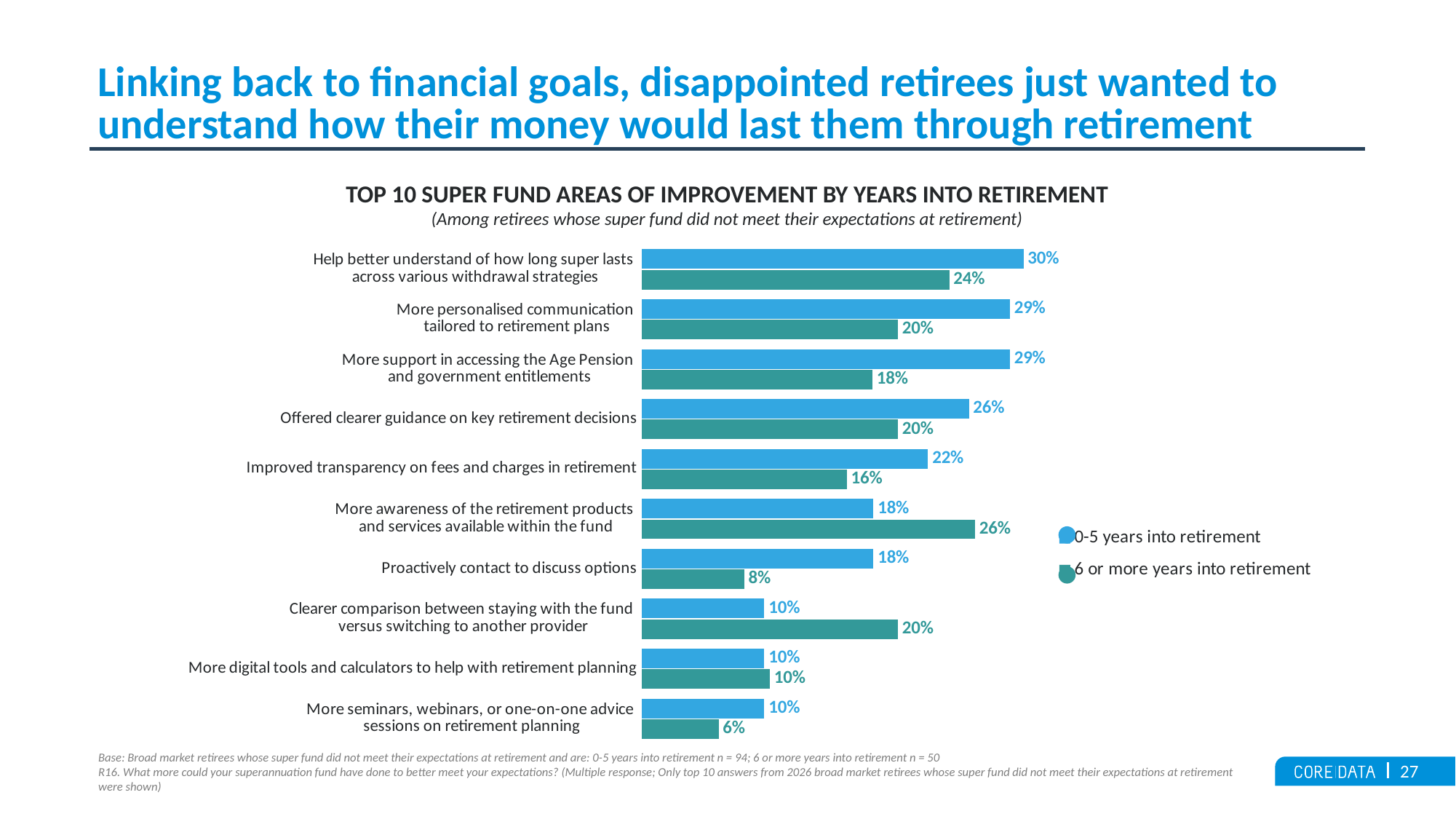
How many series does the legend list? 2 What percentage of retirees 6 or more years into retirement wanted more awareness of the retirement products and services available within the fund? 26% Which area of improvement has the highest value for retirees 0-5 years into retirement? Help better understand of how long super lasts across various withdrawal strategies What is the value for 'Proactively contact to discuss options' among retirees 6 or more years into retirement? 8% What is the difference between the two groups for 'More digital tools and calculators to help with retirement planning'? 0 percentage points How many areas of improvement are shown in the chart? 10 What is the difference between the 0-5 years and 6 or more years values for 'More support in accessing the Age Pension and government entitlements'? 11 percentage points What percentage of retirees 0-5 years into retirement wanted help better understanding how long super lasts across various withdrawal strategies? 30% Which area of improvement has the lowest value for retirees 6 or more years into retirement? More seminars, webinars, or one-on-one advice sessions on retirement planning What is the title of the chart? TOP 10 SUPER FUND AREAS OF IMPROVEMENT BY YEARS INTO RETIREMENT For 'Clearer comparison between staying with the fund versus switching to another provider', which group has the larger value: 0-5 years into retirement or 6 or more years into retirement? 6 or more years into retirement What kind of chart is shown on the slide? Bar chart